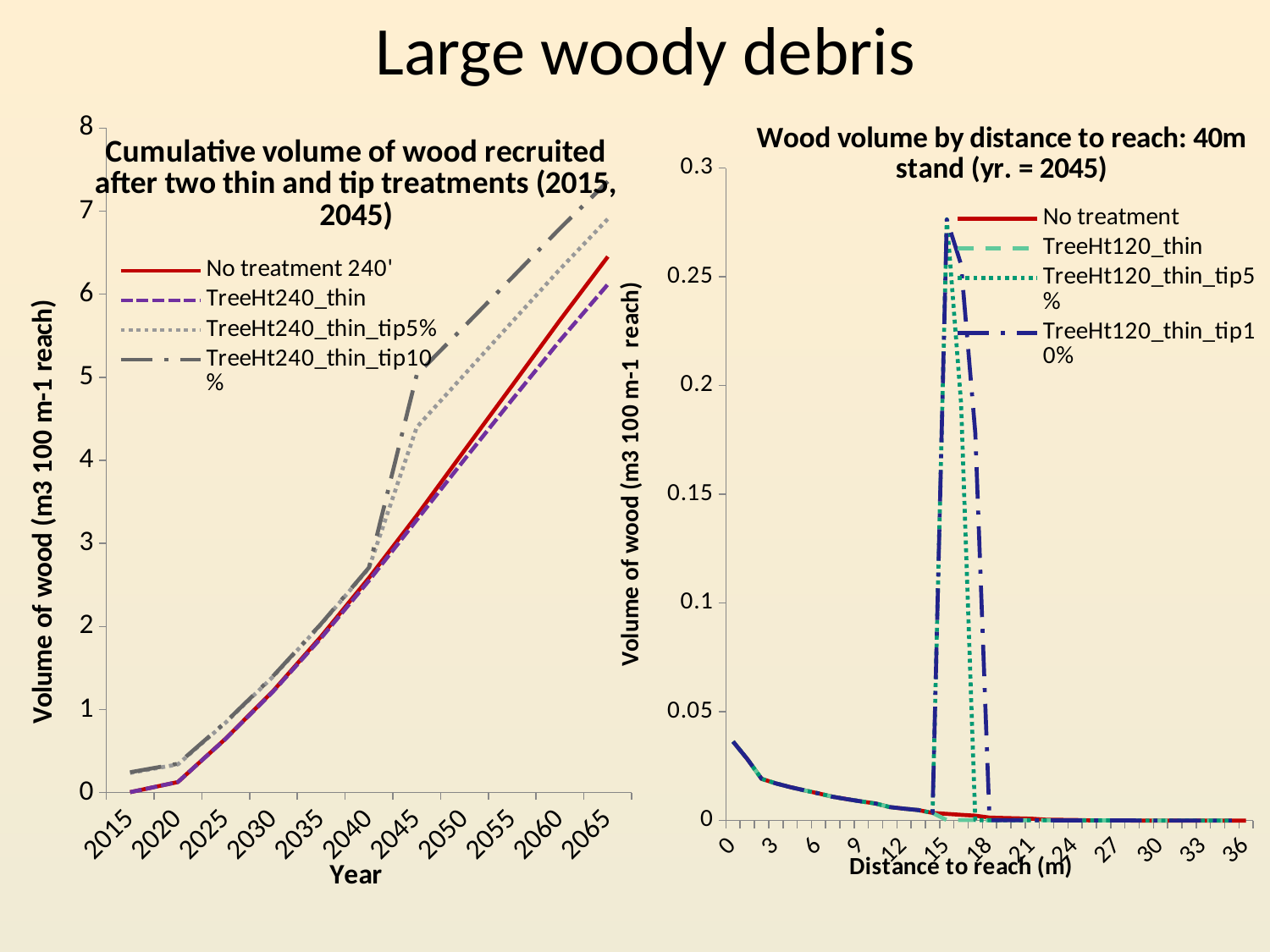
What type of chart is the right chart, 'Wood volume by distance to reach: 40m stand (yr. = 2045)'? Line chart In the left chart, is the value for 'TreeHt240_thin_tip5%' at 2040 greater or less than 3? less In the left chart, is the value for 'No treatment 240'' at 2065 greater or less than 6? greater What type of chart is the left chart, 'Cumulative volume of wood recruited after two thin and tip treatments (2015, 2045)'? Line chart What is the x-axis title of the left chart? Year In the left chart, which is larger at 2050: the value for 'TreeHt240_thin_tip10%' or the value for 'No treatment 240''? TreeHt240_thin_tip10% In the right chart, is the peak value for 'TreeHt120_thin_tip10%' near 15 m greater or less than 0.25? greater How many series does the legend of the left chart list? 4 In the left chart, do the cumulative wood volumes rise or fall from 2015 to 2065? Rise In the left chart, which series has the highest value at 2065? TreeHt240_thin_tip10% How many series does the legend of the right chart list? 4